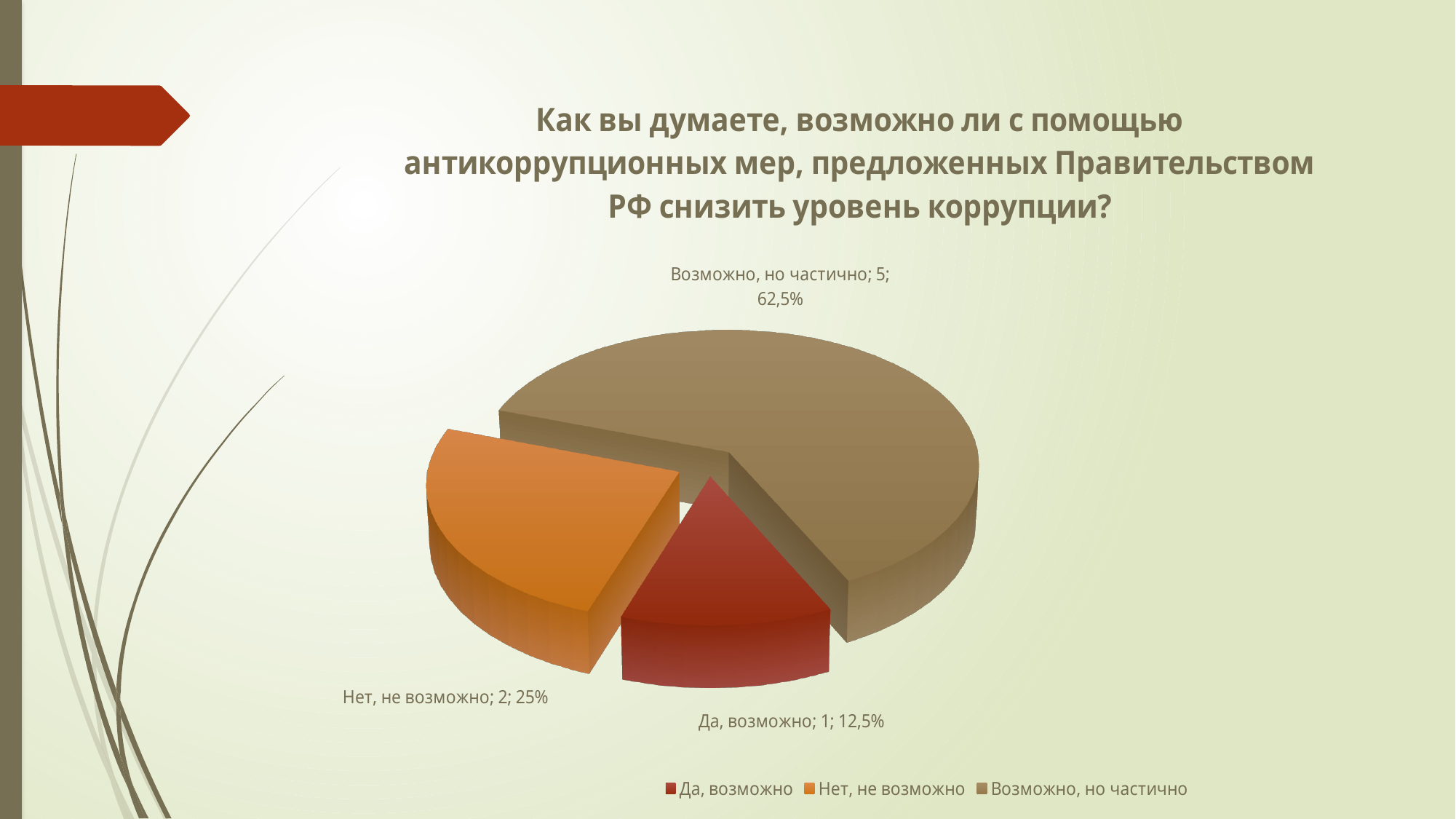
What kind of chart is shown on the slide? pie chart Which category has the largest slice? Возможно, но частично What percentage share does "Нет, не возможно" have? 25% What is the count for "Возможно, но частично"? 5 How many entries does the legend list? 3 What is the count for "Нет, не возможно"? 2 What is the difference in count between "Возможно, но частично" and "Нет, не возможно"? 3 What colour is the slice for "Да, возможно"? red Which is larger, the share for "Нет, не возможно" or for "Да, возможно"? Нет, не возможно Which category has the smallest slice? Да, возможно What percentage share does "Да, возможно" have? 12,5% How many slices does the pie chart have? 3